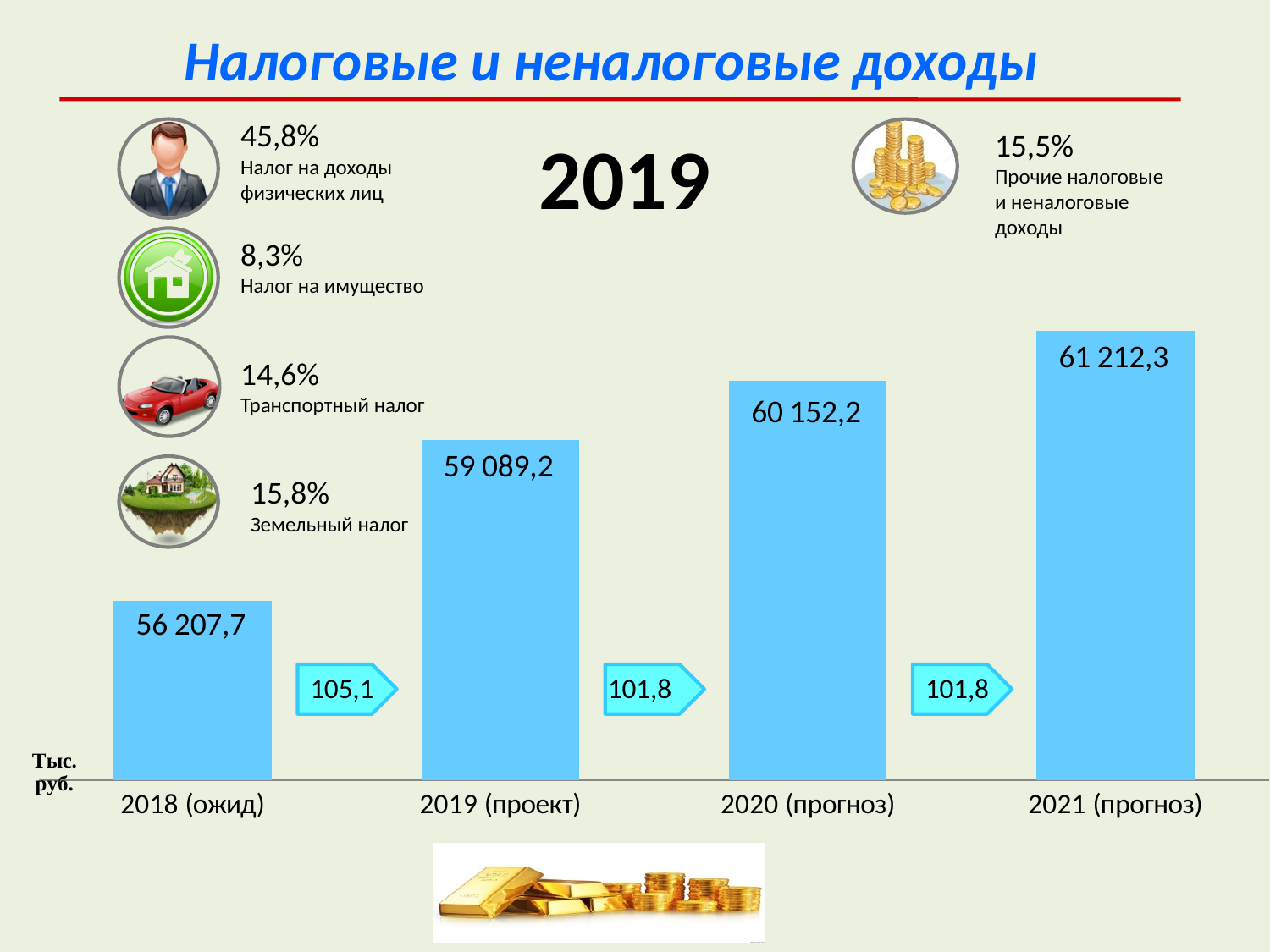
What is the value for 2020 (прогноз)? 60 152,2 What kind of chart is shown on the slide? bar chart Which is larger, the value for 2020 (прогноз) or the value for 2019 (проект)? 2020 (прогноз) What is the value for 2019 (проект)? 59 089,2 What is the difference between the values for 2021 (прогноз) and 2020 (прогноз)? 1 060,1 Do the values rise or fall from 2018 (ожид) to 2021 (прогноз)? rise What is the value for 2018 (ожид)? 56 207,7 What is the value for 2021 (прогноз)? 61 212,3 Which category has the lowest value? 2018 (ожид) What is the difference between the values for 2019 (проект) and 2018 (ожид)? 2 881,5 Which category has the highest value? 2021 (прогноз) How many categories are shown on the x axis of the chart? 4